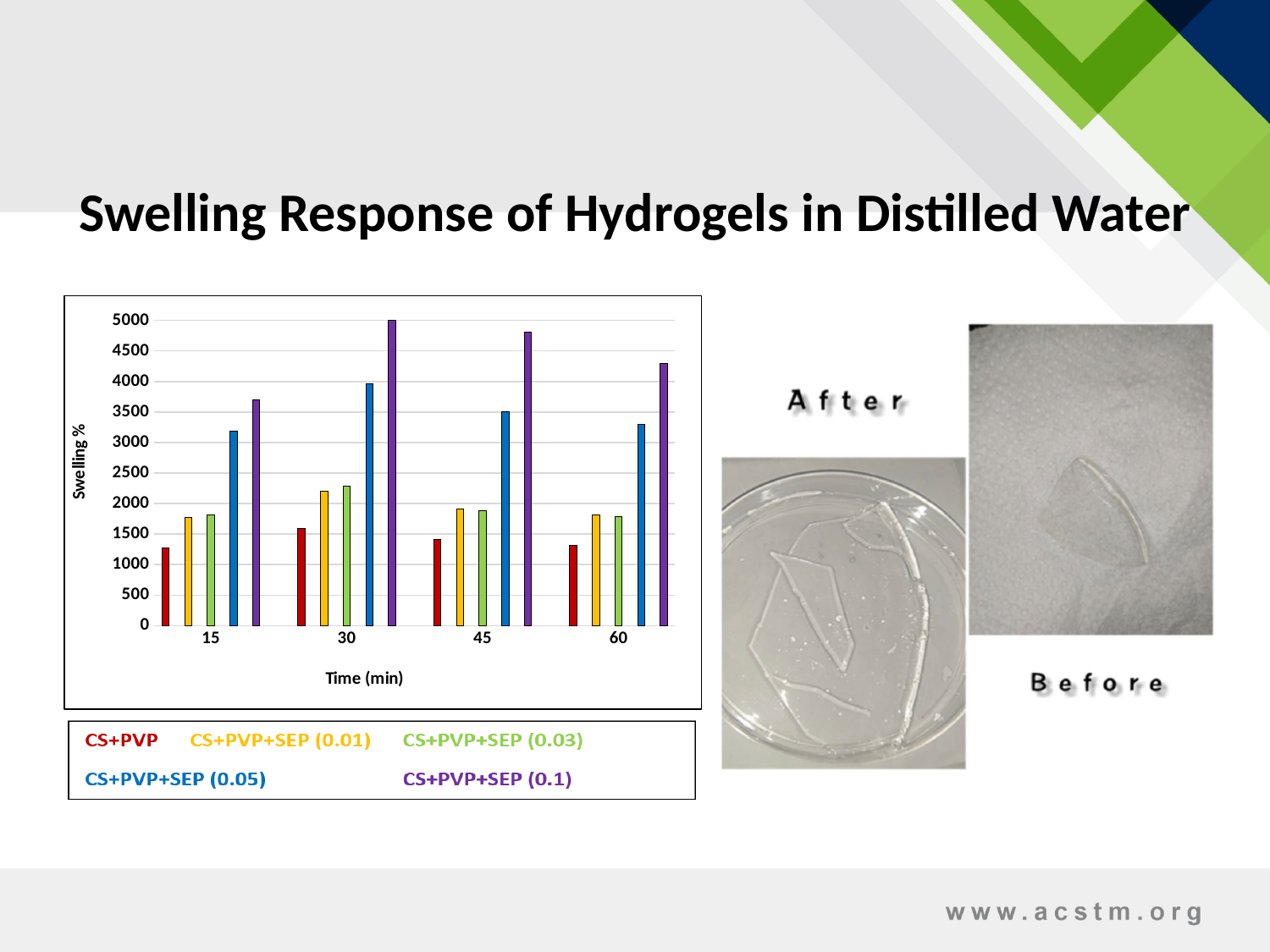
At which time point does CS+PVP+SEP (0.1) reach its highest swelling %? 30 How many series does the legend list for the swelling chart? 5 Is the swelling % for CS+PVP+SEP (0.05) at 30 min greater or less than 3500? greater Is the swelling % for CS+PVP+SEP (0.1) at 60 min greater or less than 4000? greater How many time points are shown on the x axis of the swelling chart? 4 Which series has the highest swelling % at 30 min? CS+PVP+SEP (0.1) What is the title of the x axis of the chart? Time (min) What is the title of the y axis of the chart? Swelling % Which series has the lowest swelling % at 15 min? CS+PVP What kind of chart is shown on the slide? bar chart Is the swelling % for CS+PVP at 15 min greater or less than 1500? less At 45 min, which is larger: the swelling % for CS+PVP+SEP (0.1) or for CS+PVP+SEP (0.05)? CS+PVP+SEP (0.1)